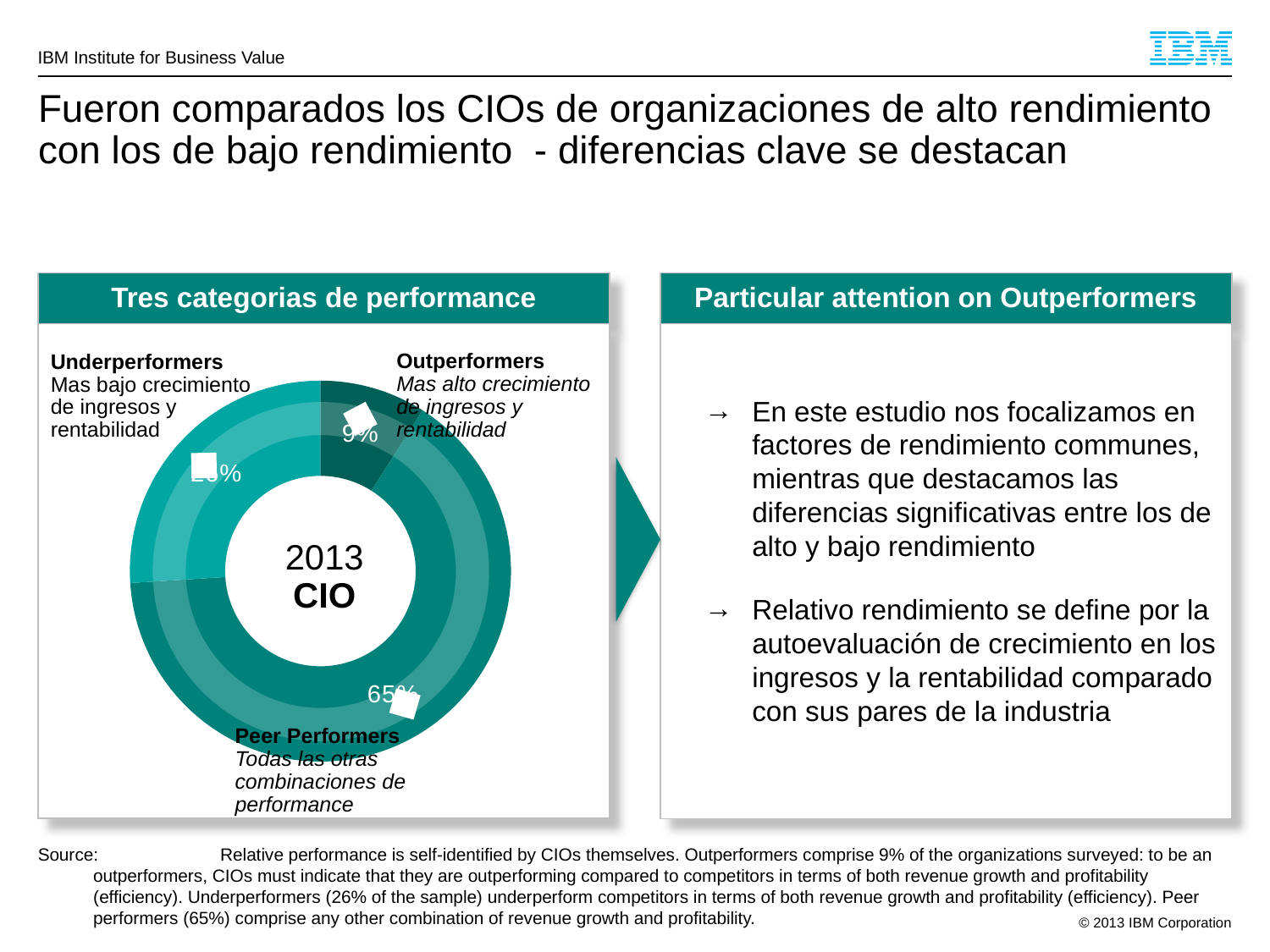
Which is larger, the share for Underperformers or the share for Outperformers? Underperformers What percentage of the donut chart is Peer Performers? 65% What kind of chart is shown on the slide? Donut chart What text appears in the centre of the donut chart? 2013 CIO What percentage of the donut chart is Outperformers? 9% How many categories does the donut chart show? 3 What is the difference in percentage points between Peer Performers and Underperformers? 39 What percentage of the donut chart is Underperformers? 26% What is the difference in percentage points between Underperformers and Outperformers? 17 Which category has the largest share of the donut chart? Peer Performers What is the title of the panel containing the donut chart? Tres categorias de performance Which category has the smallest share of the donut chart? Outperformers